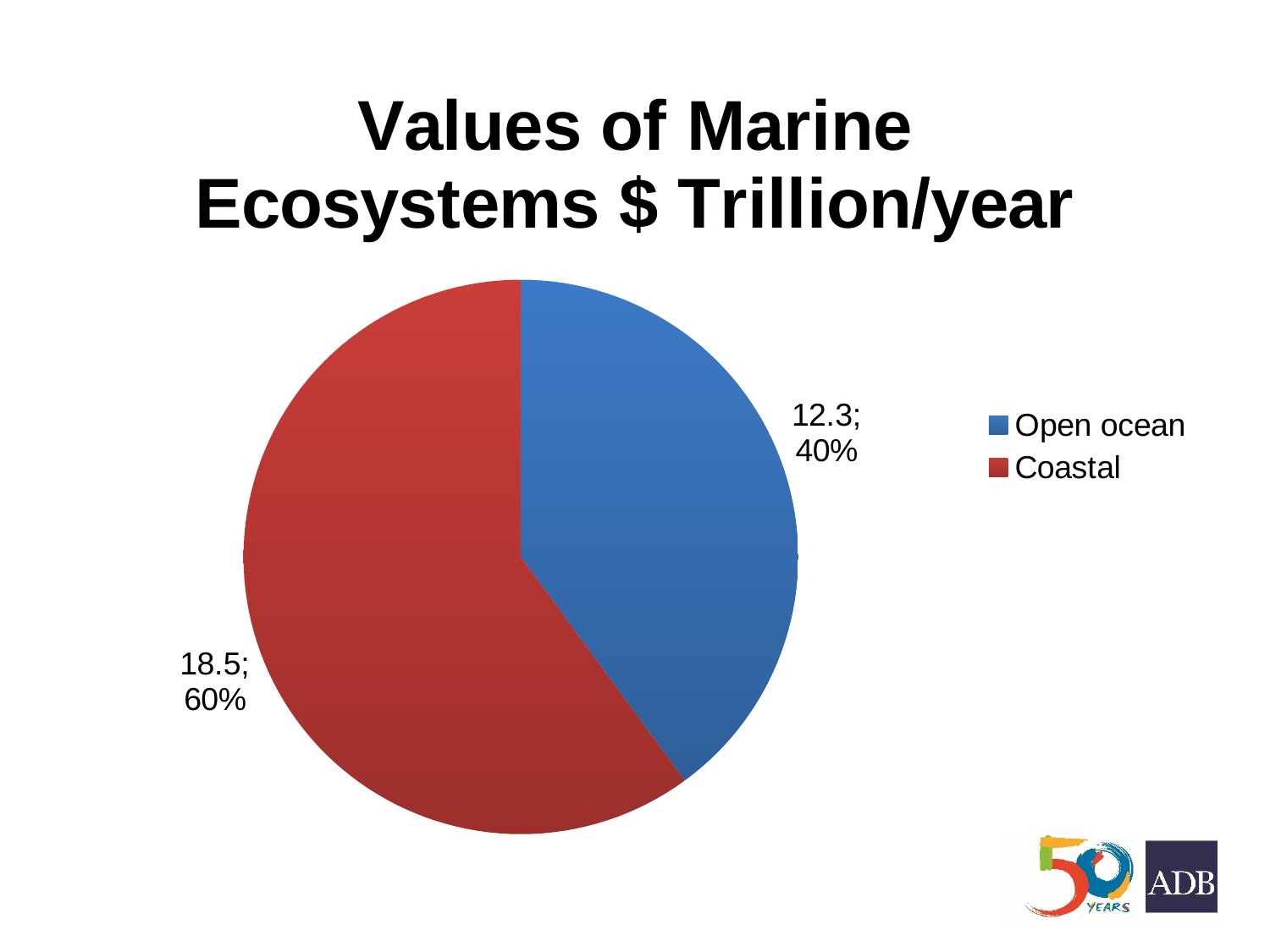
What share of the pie does Open ocean represent? 40% Which category has the smallest slice? Open ocean What is the title of the chart? Values of Marine Ecosystems $ Trillion/year Which category has the largest slice? Coastal How many categories does the pie chart show? 2 What is the value for Coastal? 18.5 What is the difference between the Coastal and Open ocean values? 6.2 What colour is the Coastal slice? red What kind of chart is shown on the slide? pie chart What share of the pie does Coastal represent? 60% Which is larger, the value for Coastal or the value for Open ocean? Coastal What is the value for Open ocean? 12.3